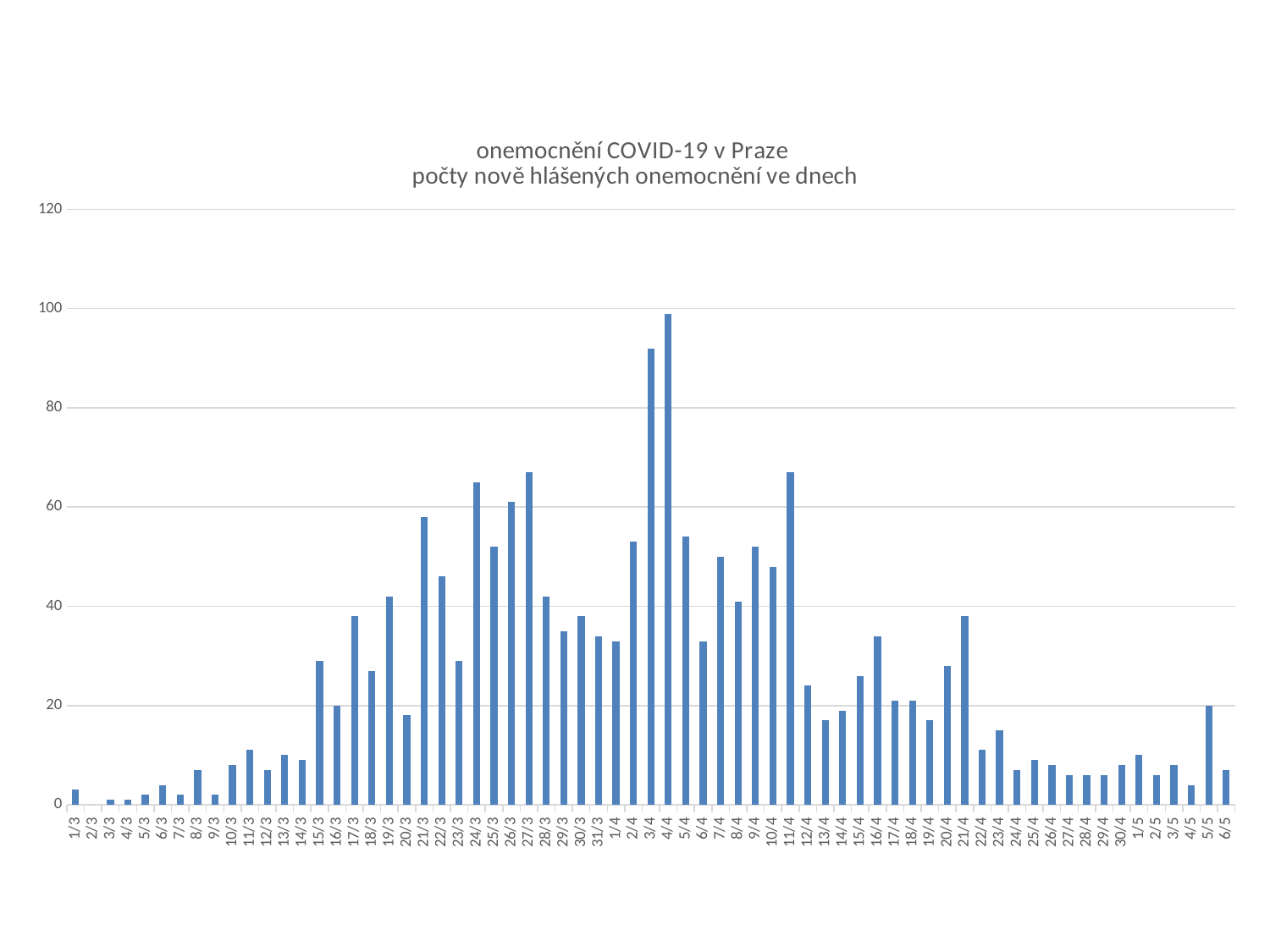
What is the first line of the chart title? onemocnění COVID-19 v Praze Which date has the lowest number of newly reported cases? 2/3 Is the value for 22/3 greater or less than 40? greater Is the value for 27/3 greater or less than 60? greater Is the value for 1/3 greater or less than 20? less Which date has the larger value, 3/4 or 4/4? 4/4 Do the values generally rise or fall from 4/4 to 6/5? fall What kind of chart is shown on the slide? bar chart Which date has the highest number of newly reported cases? 4/4 Which date has the larger value, 5/5 or 6/5? 5/5